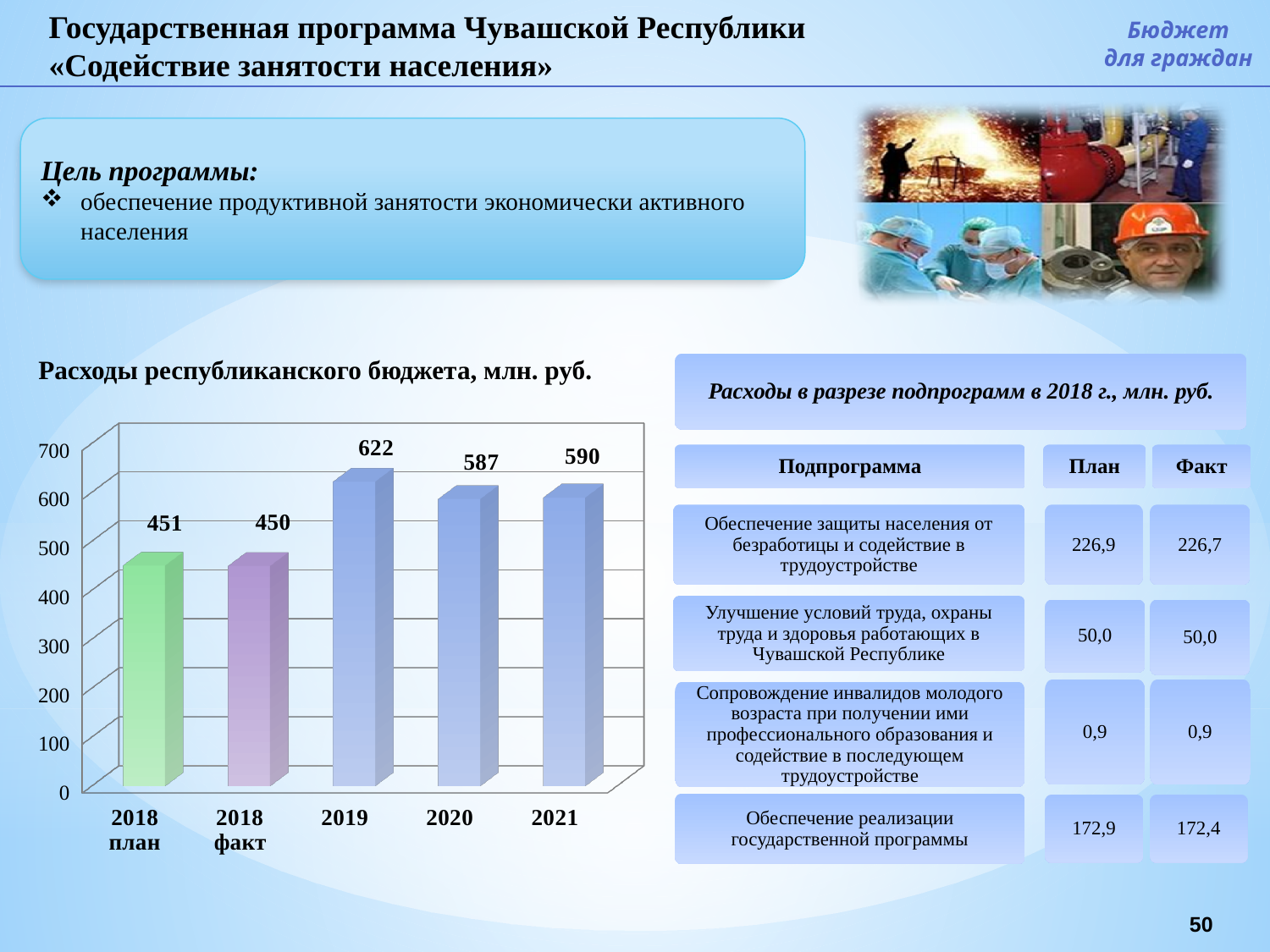
What is the value for 2019 in the chart "Расходы республиканского бюджета, млн. руб."? 622 Is the value for 2020 greater or less than 500? greater Which category has the lowest value in the chart? 2018 факт How many bars are shown in the chart? 5 What is the value for 2018 факт in the chart? 450 What is the difference between the values for 2018 план and 2018 факт in the chart? 1 What is the value for 2021 in the chart? 590 What is the difference between the values for 2019 and 2020 in the chart? 35 What kind of chart is shown on the slide? bar chart Which category has the highest value in the chart? 2019 Which is larger in the chart: the value for 2020 or the value for 2019? 2019 What is the value for 2018 план in the chart? 451